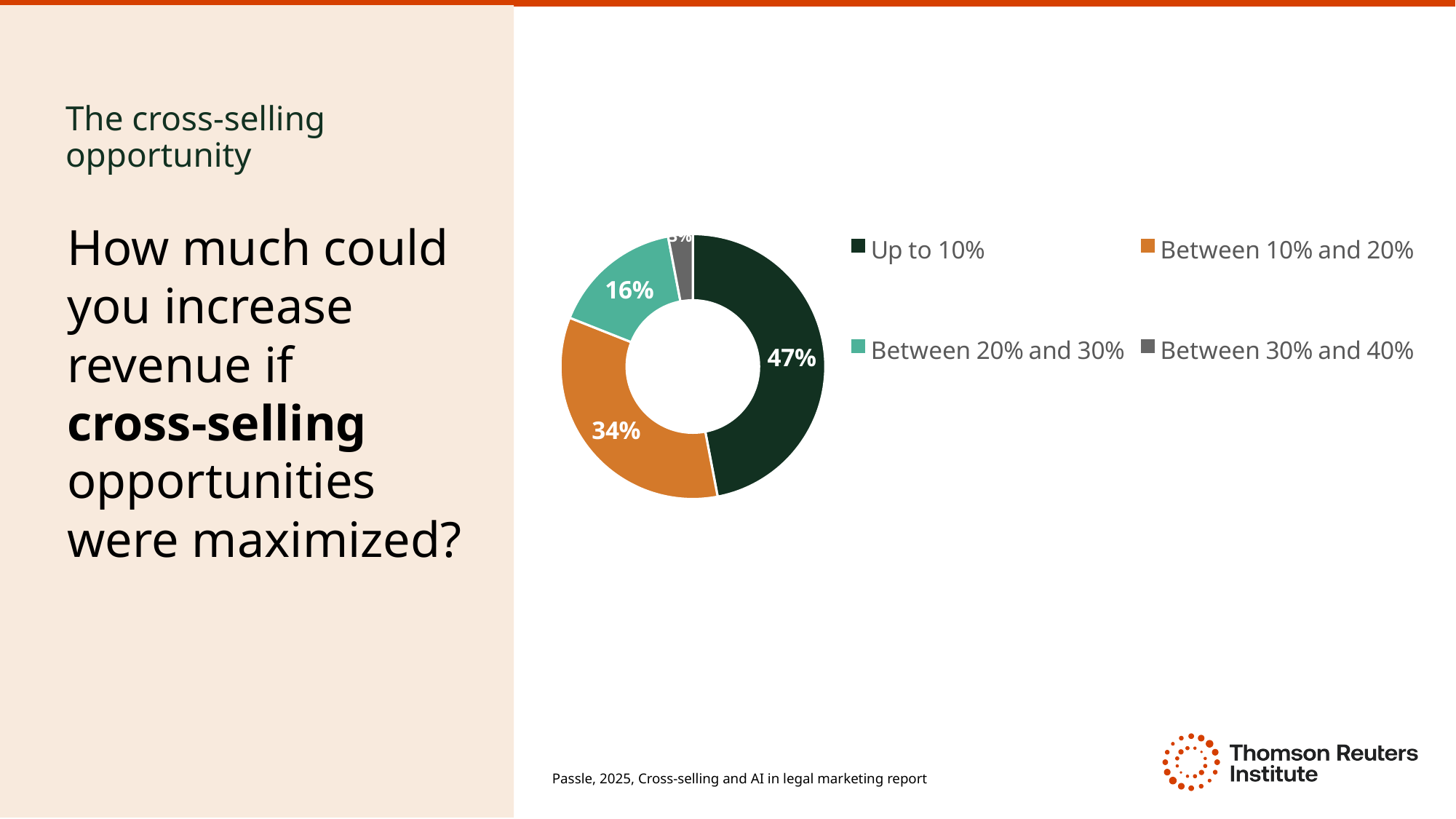
What percentage of respondents said revenue could increase by up to 10% if cross-selling opportunities were maximized? 47% How many categories are shown in the pie chart? 4 What is the combined share of the 'Up to 10%' and 'Between 10% and 20%' slices? 81% What value is shown for the 'Between 20% and 30%' slice? 16% What is the difference in percentage points between the 'Up to 10%' slice and the 'Between 10% and 20%' slice? 13 percentage points Which slice is larger: 'Between 10% and 20%' or 'Between 20% and 30%'? Between 10% and 20% Which category has the smallest slice of the pie chart? Between 30% and 40% What type of chart is shown on the slide? Pie chart (donut) How many entries does the chart legend list? 4 What share of the pie chart corresponds to 'Between 10% and 20%'? 34% Which category has the largest slice of the pie chart? Up to 10% Which colour represents the 'Between 20% and 30%' category in the legend? Teal/green